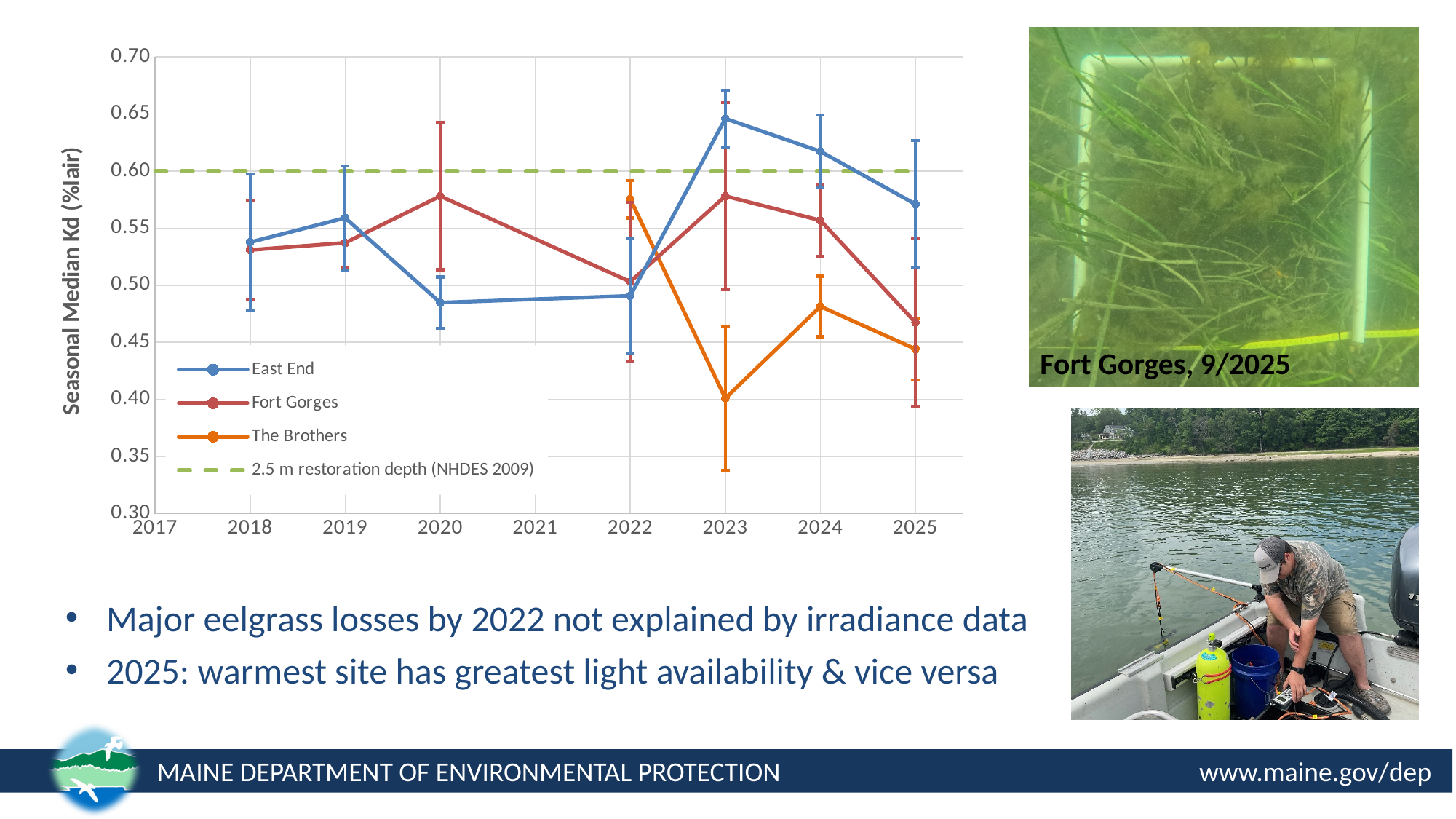
Does the value for The Brothers rise or fall from 2022 to 2023? fall How many entries does the chart legend list? 4 At what y-axis value is the dashed 2.5 m restoration depth (NHDES 2009) line drawn? 0.60 Which site has the highest value in 2023? East End What kind of chart is shown on the slide? line chart What is the y-axis label of the chart? Seasonal Median Kd (%Iair) In 2020, which is larger: the value for East End or the value for Fort Gorges? Fort Gorges Is the value for The Brothers in 2023 greater or less than 0.45? less Is the value for Fort Gorges in 2025 greater or less than 0.50? less Is the value for East End in 2023 greater or less than 0.60? greater In which year does the East End series reach its highest value? 2023 Which site has the lowest value in 2023? The Brothers